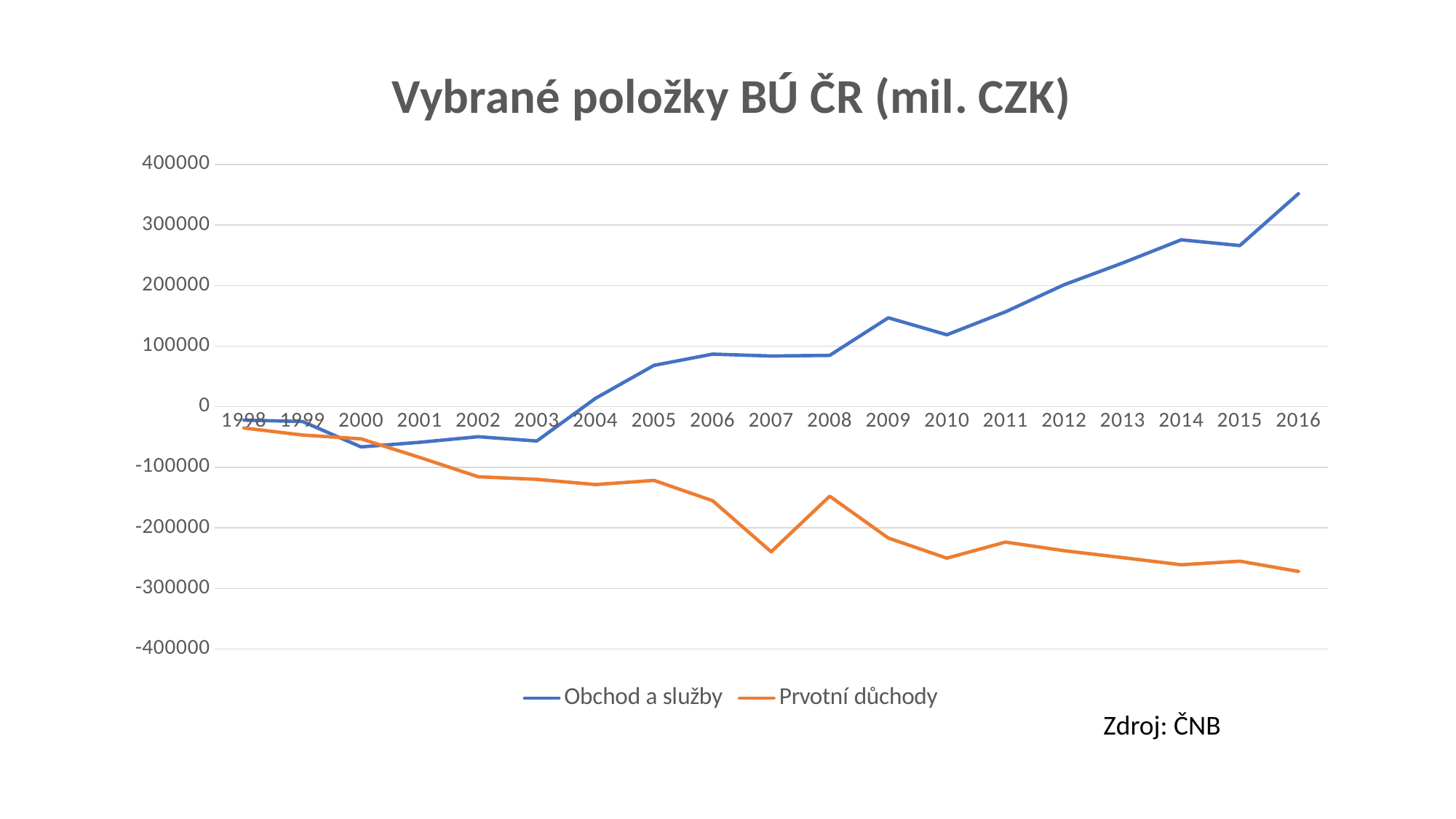
In which year is the value for Obchod a služby highest? 2016 In which year is the value for Prvotní důchody highest? 1998 Is the value for Obchod a služby in 2003 greater or less than 0? less Is the value for Obchod a služby in 2016 greater or less than 300000? greater Is the value for Prvotní důchody in 2007 greater or less than -200000? less Which is larger for Obchod a služby: the value in 2009 or the value in 2010? 2009 What is the title of the chart? Vybrané položky BÚ ČR (mil. CZK) What kind of chart is shown on the slide? line chart How many series does the legend list? 2 How many years are plotted along the x axis? 19 Does the value for Prvotní důchody generally rise or fall from 1998 to 2016? fall Does the value for Obchod a služby rise or fall from 2010 to 2014? rise